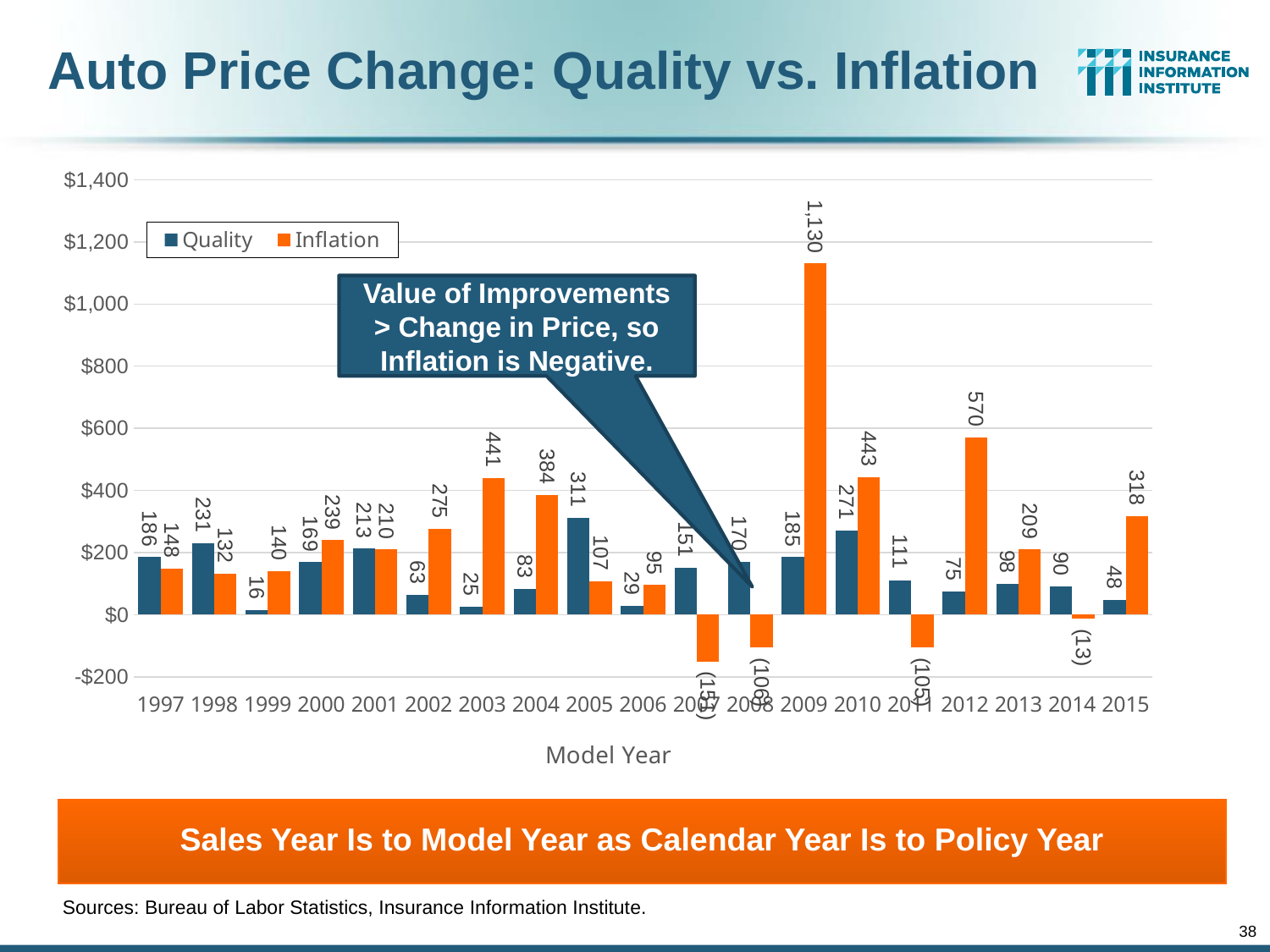
What is the difference between the Inflation and Quality values for model year 2003? 416 Which model year has the lowest Quality value? 1999 What is the Inflation value for model year 2012? 570 What is the Quality value for model year 1999? 16 What is the Quality value for model year 2005? 311 Is the Inflation value for model year 2014 greater or less than $0? less For model year 1998, which is larger, Quality or Inflation? Quality What kind of chart is shown on the slide? bar chart What is the Inflation value for model year 2009? 1,130 How many model years are shown on the x axis? 19 How many series does the legend list? 2 Which model year has the highest Inflation value? 2009